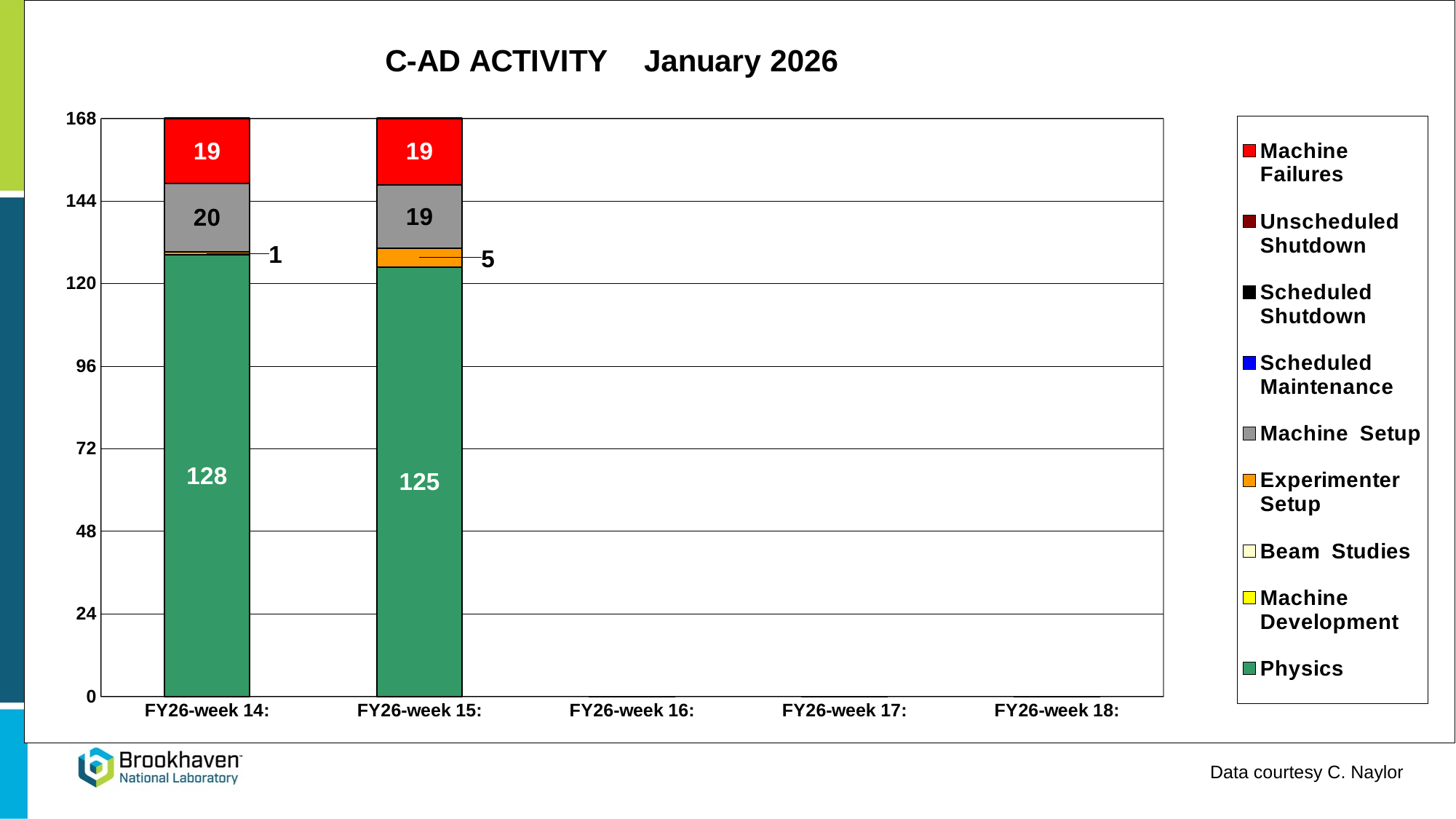
What kind of chart is shown on the slide? Stacked bar chart What is the Physics value for FY26-week 14? 128 How many week categories are shown on the x axis? 5 What is the title of the chart? C-AD ACTIVITY January 2026 What is the Physics value for FY26-week 15? 125 Which week has the larger Physics value, FY26-week 14 or FY26-week 15? FY26-week 14 What is the difference in Physics hours between FY26-week 14 and FY26-week 15? 3 What is the total of the stacked bar for FY26-week 15? 168 How many series does the legend list? 9 What is the Experimenter Setup value for FY26-week 15? 5 What is the Machine Setup value for FY26-week 14? 20 What is the Machine Failures value for FY26-week 15? 19